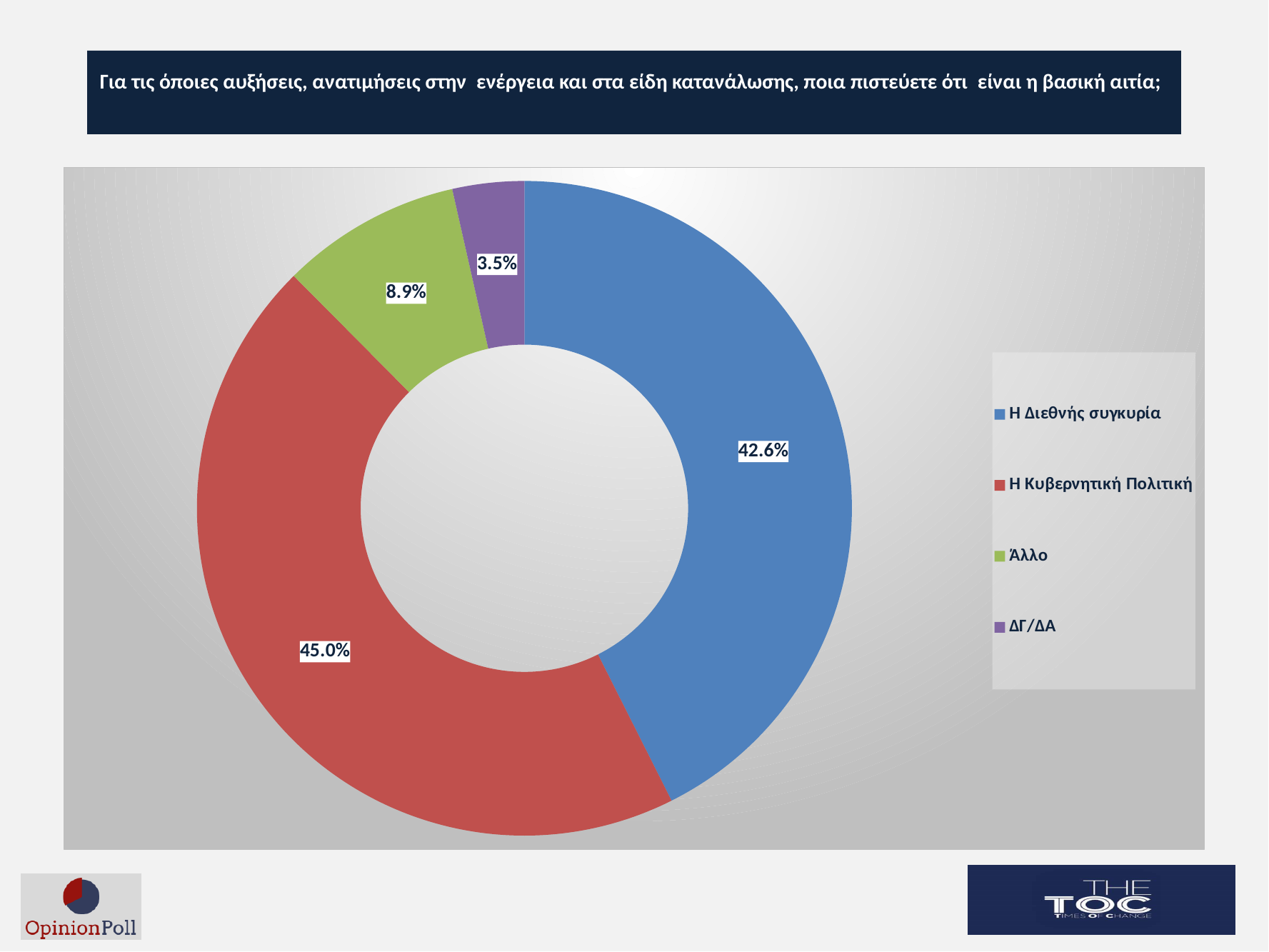
Which is larger, the share for Άλλο or the share for ΔΓ/ΔΑ? Άλλο Which category has the smallest share? ΔΓ/ΔΑ What percentage is shown for Η Διεθνής συγκυρία? 42.6% What percentage is shown for Άλλο? 8.9% Which category has the largest share? Η Κυβερνητική Πολιτική What is the difference in percentage points between Άλλο and ΔΓ/ΔΑ? 5.4 What percentage is shown for Η Κυβερνητική Πολιτική? 45.0% What is the difference in percentage points between Η Κυβερνητική Πολιτική and Η Διεθνής συγκυρία? 2.4 What colour represents Η Διεθνής συγκυρία in the chart? Blue What percentage is shown for ΔΓ/ΔΑ? 3.5% How many categories does the chart show? 4 What kind of chart is shown on the slide? Doughnut (pie) chart